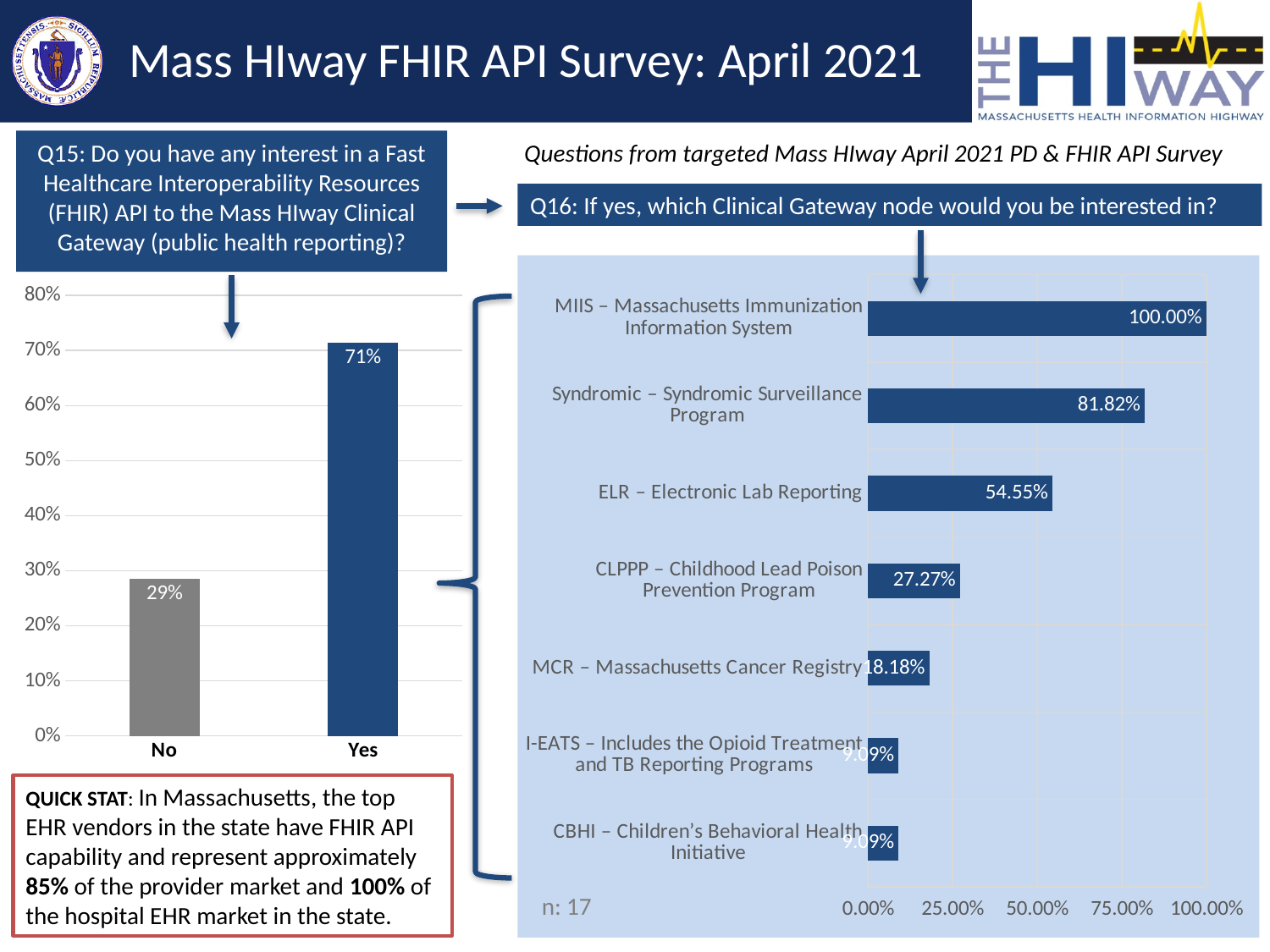
In the Q16 chart on the right, how many Clinical Gateway nodes are shown? 7 In the Q16 chart on the right, what is the value for ELR – Electronic Lab Reporting? 54.55% In the Q15 chart on the left, what is the difference between the Yes and No percentages? 42% In the Q15 chart on the left, what percentage of respondents answered No? 29% In the Q16 chart on the right, which Clinical Gateway node has the highest value? MIIS – Massachusetts Immunization Information System What kind of chart is the Q15 chart on the left? Bar chart In the Q16 chart on the right, what is the value for MIIS – Massachusetts Immunization Information System? 100.00% In the Q15 chart on the left, what percentage of respondents answered Yes? 71% In the Q16 chart on the right, what is the difference between the Syndromic Surveillance Program and ELR – Electronic Lab Reporting values? 27.27% In the Q16 chart on the right, what is the value for CLPPP – Childhood Lead Poison Prevention Program? 27.27% In the Q16 chart on the right, which has the larger value, MCR – Massachusetts Cancer Registry or CLPPP – Childhood Lead Poison Prevention Program? CLPPP – Childhood Lead Poison Prevention Program In the Q15 chart on the left, which response has the larger value, No or Yes? Yes